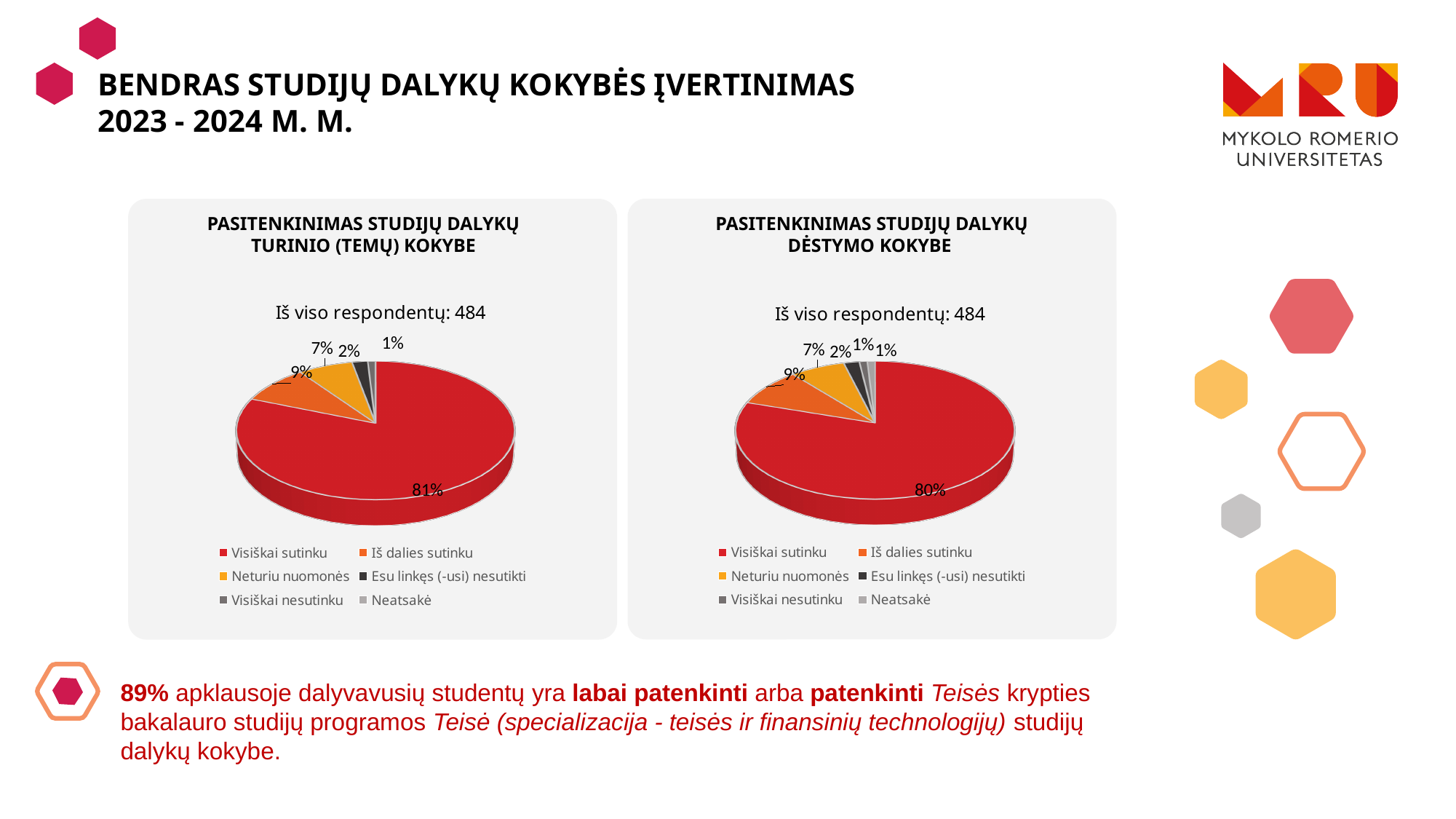
In the left chart (Pasitenkinimas studijų dalykų turinio (temų) kokybe), what is the difference in percentage points between "Visiškai sutinku" and "Iš dalies sutinku"? 72 In the right chart (Pasitenkinimas studijų dalykų dėstymo kokybe), which is larger: "Iš dalies sutinku" or "Neturiu nuomonės"? Iš dalies sutinku In the right chart (Pasitenkinimas studijų dalykų dėstymo kokybe), what share is labelled for "Neturiu nuomonės"? 7% In the right chart (Pasitenkinimas studijų dalykų dėstymo kokybe), what share of respondents answered "Visiškai sutinku"? 80% In the left chart (Pasitenkinimas studijų dalykų turinio (temų) kokybe), what share is labelled for "Iš dalies sutinku"? 9% In the left chart (Pasitenkinimas studijų dalykų turinio (temų) kokybe), what share of respondents answered "Visiškai sutinku"? 81% In the left chart (Pasitenkinimas studijų dalykų turinio (temų) kokybe), which category has the largest slice? Visiškai sutinku According to the left chart (Pasitenkinimas studijų dalykų turinio (temų) kokybe), how many respondents took part in total? 484 In the right chart (Pasitenkinimas studijų dalykų dėstymo kokybe), which category has the largest slice? Visiškai sutinku What type of chart is used in the right chart (Pasitenkinimas studijų dalykų dėstymo kokybe)? Pie chart How many categories does the legend of the left chart (Pasitenkinimas studijų dalykų turinio (temų) kokybe) list? 6 Which chart shows a larger share for "Visiškai sutinku": the left chart (turinio kokybe) or the right chart (dėstymo kokybe)? The left chart (turinio kokybe)